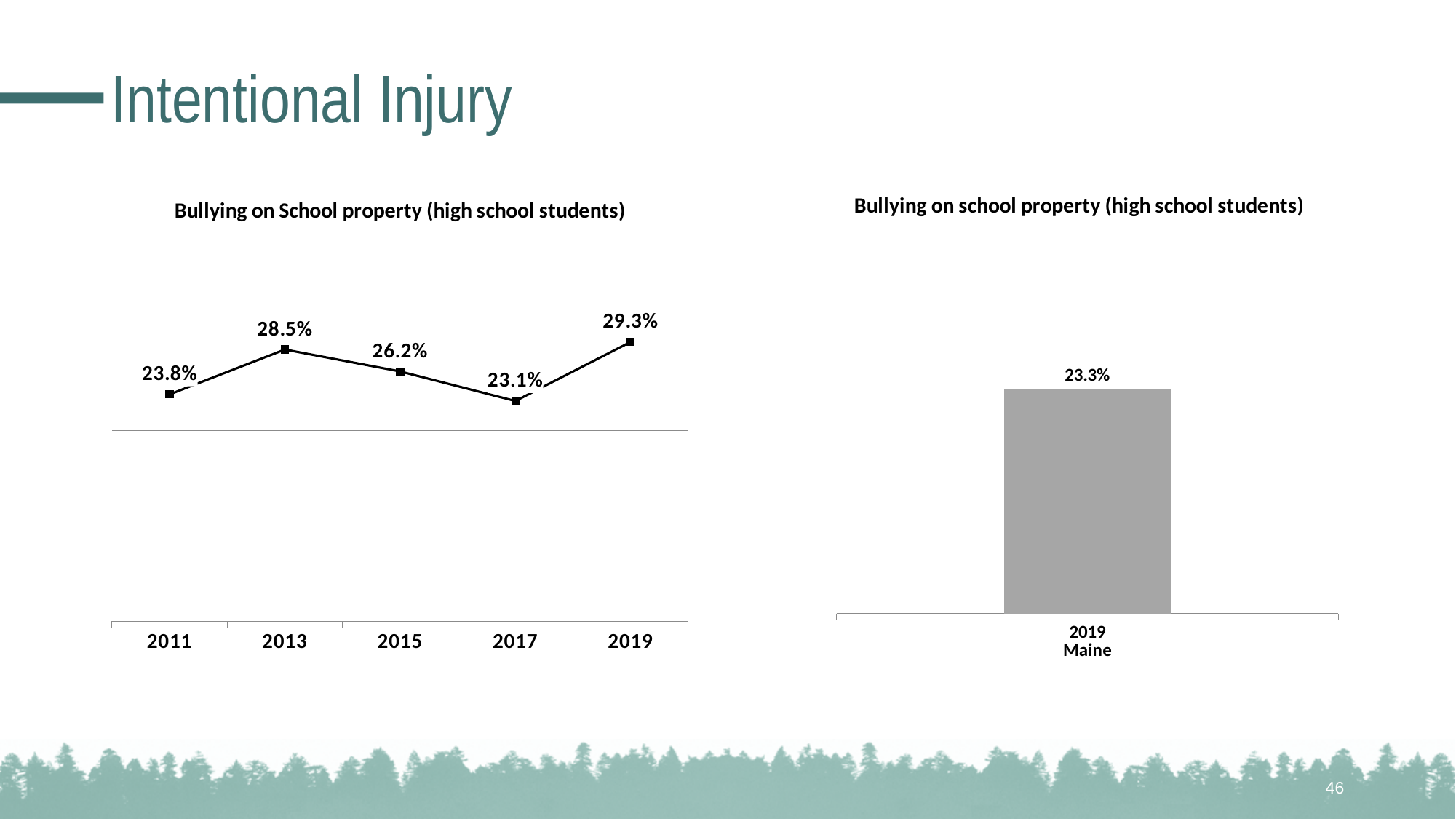
What kind of chart is the chart on the left? line chart In the left line chart, which year has the lowest value? 2017 What kind of chart is the chart on the right? bar chart In the left line chart, which is larger, the value for 2013 or the value for 2015? 2013 In the left line chart, what is the value for 2011? 23.8% In the left line chart, what is the value for 2017? 23.1% In the left line chart, what is the difference between the 2019 value and the 2017 value? 6.2% How many data points are plotted in the left line chart? 5 In the left line chart, does the value rise or fall from 2017 to 2019? rise In the left line chart, which year has the highest value? 2019 In the right bar chart, what is the value for 2019 Maine? 23.3% How many bars are shown in the right bar chart? 1